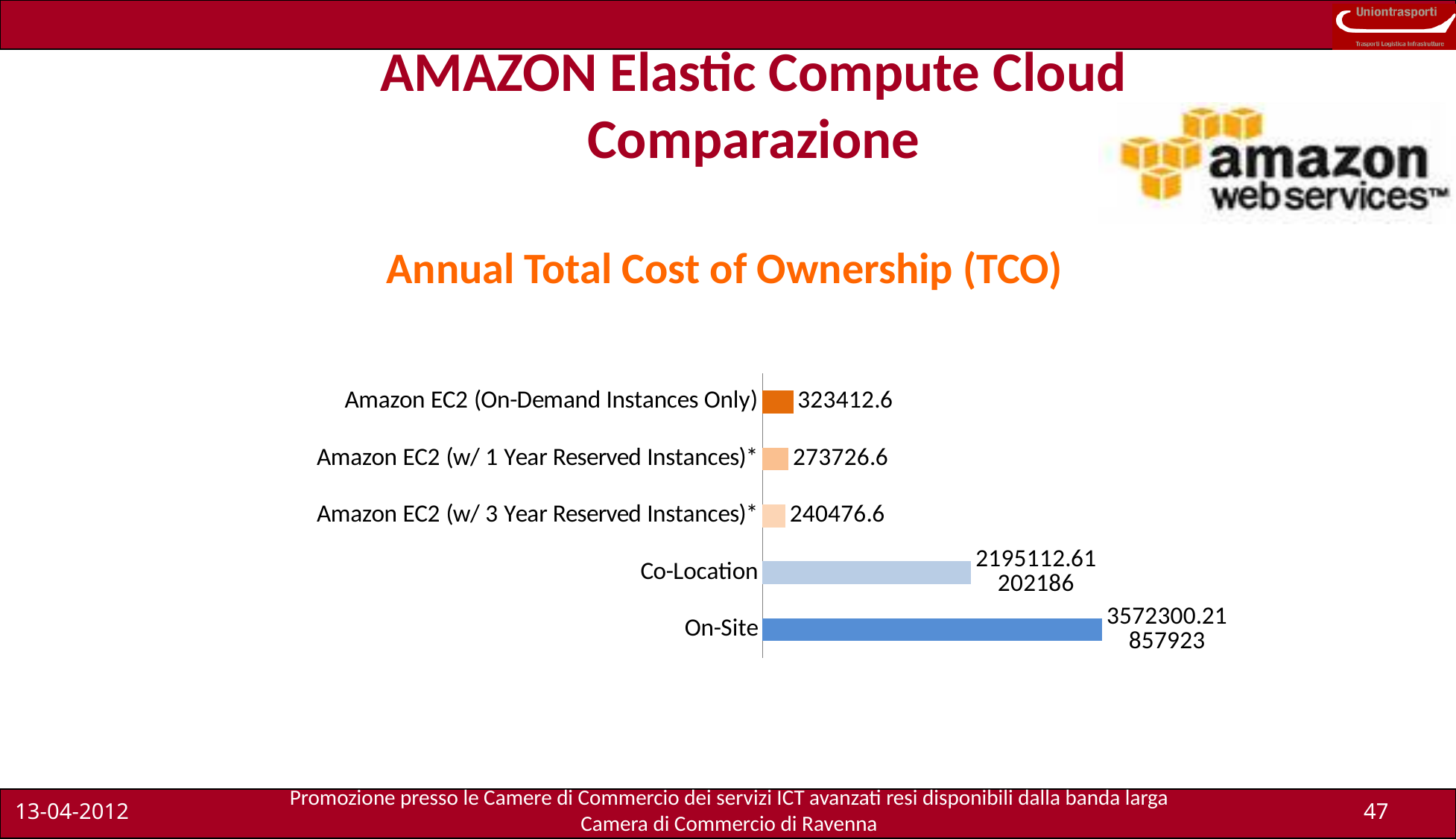
Which is larger, the value for Amazon EC2 (On-Demand Instances Only) or the value for Co-Location? Co-Location What is the difference between Amazon EC2 (On-Demand Instances Only) and Amazon EC2 (w/ 1 Year Reserved Instances)*? 49686 What is the value for Amazon EC2 (On-Demand Instances Only)? 323412.6 Which is larger, the value for Co-Location or the value for On-Site? On-Site What is the value for Amazon EC2 (w/ 1 Year Reserved Instances)*? 273726.6 Which category has the lowest value? Amazon EC2 (w/ 3 Year Reserved Instances)* Which category has the highest value? On-Site What type of chart is shown on the slide? bar chart What is the difference between Amazon EC2 (w/ 1 Year Reserved Instances)* and Amazon EC2 (w/ 3 Year Reserved Instances)*? 33250 What is the value for Amazon EC2 (w/ 3 Year Reserved Instances)*? 240476.6 How many categories are plotted in the chart? 5 What is the title shown above the chart? Annual Total Cost of Ownership (TCO)